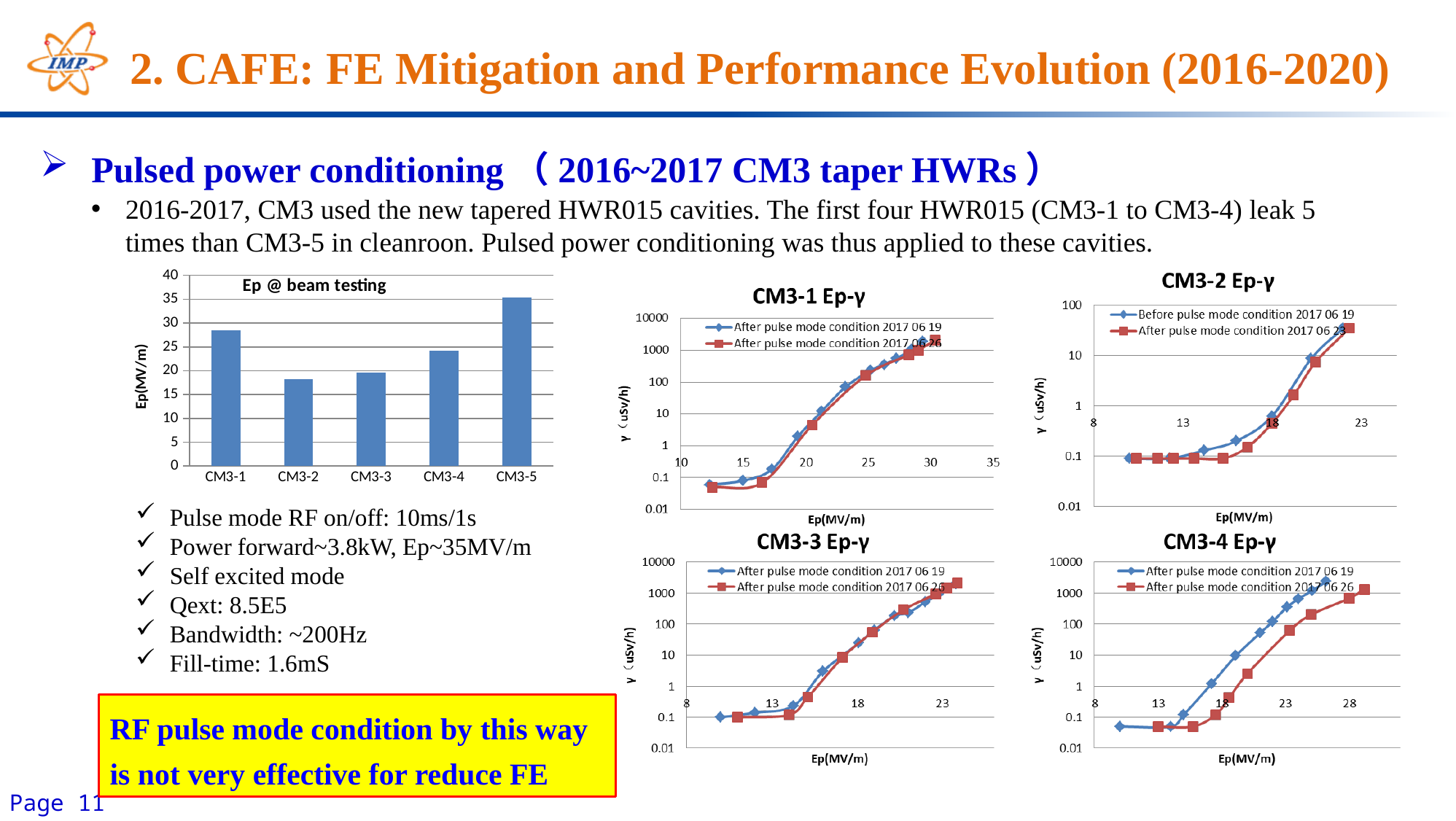
How many series does the legend of the 'CM3-2 Ep-γ' chart list? 2 In the 'Ep @ beam testing' chart, is the value for CM3-5 greater or less than 30? greater How many cavities are shown in the 'Ep @ beam testing' chart? 5 In the 'CM3-4 Ep-γ' chart, do the γ values rise or fall as Ep increases? rise In the 'Ep @ beam testing' chart, which cavity has the lowest Ep? CM3-2 What is the y-axis label of the 'Ep @ beam testing' chart? Ep(MV/m) In the 'Ep @ beam testing' chart, which cavity has the highest Ep? CM3-5 What kind of chart is the 'Ep @ beam testing' chart? bar chart In the 'Ep @ beam testing' chart, which is larger, the value for CM3-1 or the value for CM3-4? CM3-1 In the 'Ep @ beam testing' chart, is the value for CM3-1 greater or less than 25? greater What kind of chart is the 'CM3-1 Ep-γ' chart? line chart